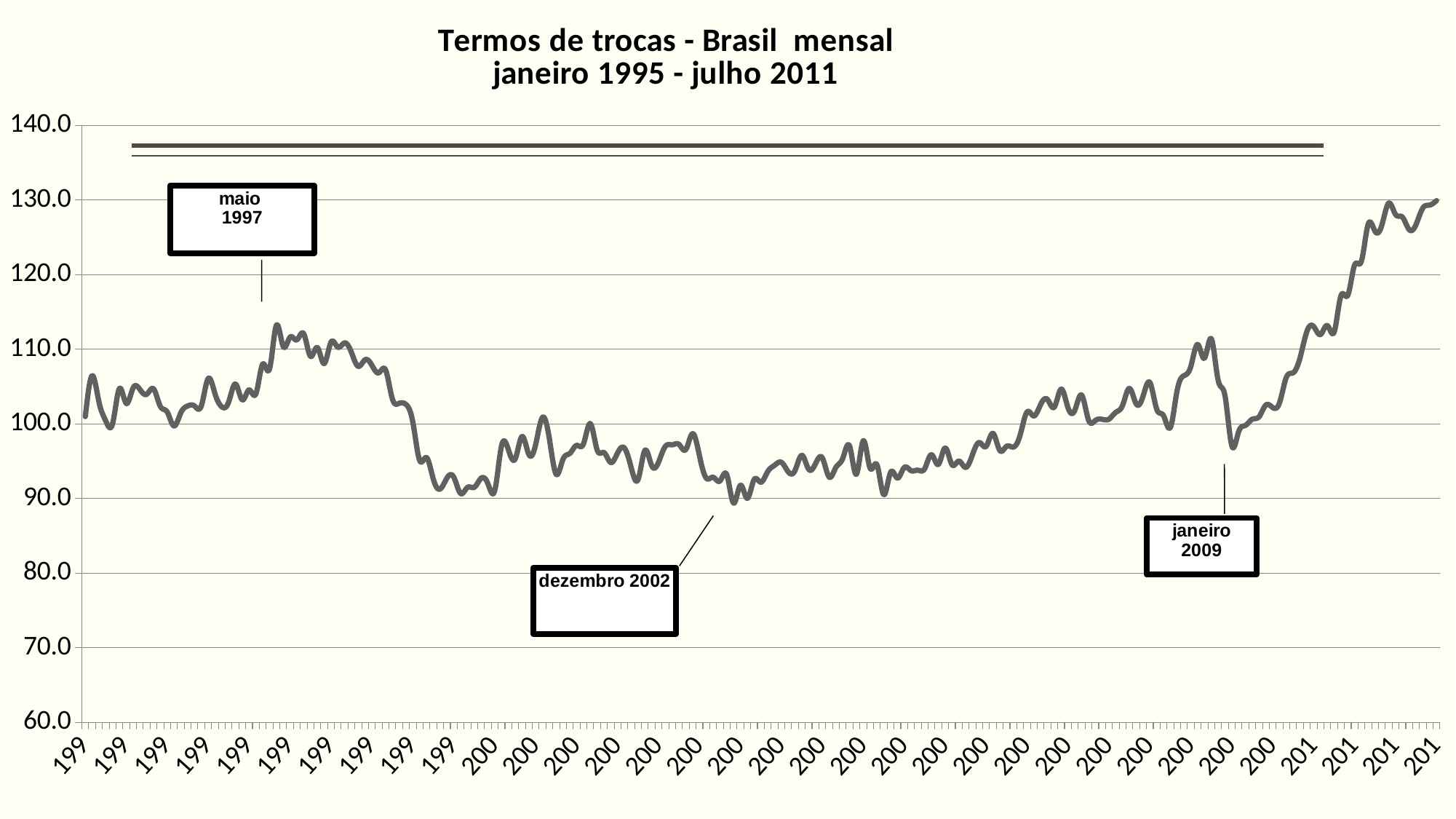
Which three dates are called out with annotation boxes on the chart? maio 1997, dezembro 2002, janeiro 2009 What is the title of the chart? Termos de trocas - Brasil mensal janeiro 1995 - julho 2011 Which is larger: the value at 'dezembro 2002' or the value at 'janeiro 2009'? janeiro 2009 Around which annotated date does the series reach its lowest point? dezembro 2002 Does the series rise or fall between the 'janeiro 2009' annotation and the end of the series in 2011? rise Is the value at the point annotated 'dezembro 2002' greater or less than 100? less What kind of chart is shown on the slide? line chart Does the series rise or fall between the 'maio 1997' annotation and the 'dezembro 2002' annotation? fall Is the value at the point annotated 'maio 1997' greater or less than 110? greater Is the value at the end of the series (julho 2011) greater or less than 120? greater Which is larger: the value at the 'maio 1997' peak or the value at the end of the series in 2011? the end of the series in 2011